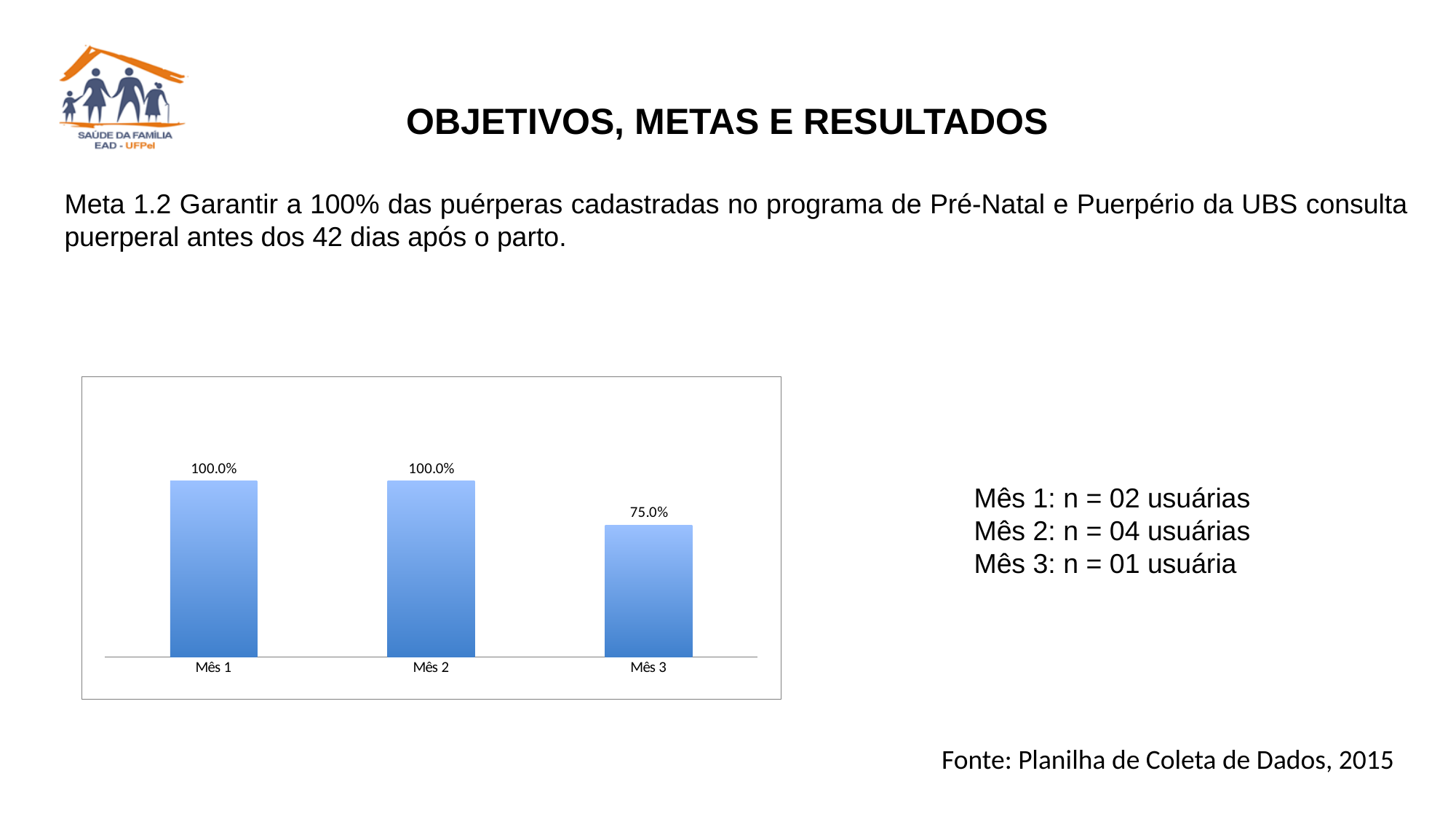
What is the difference between the values for Mês 1 and Mês 3? 25.0% How many categories are shown on the x axis of the chart? 3 Do the values rise or fall from Mês 2 to Mês 3? Fall Are the values for Mês 1 and Mês 2 equal? Yes According to the text beside the chart, how many users (usuárias) does Mês 2 correspond to? 04 usuárias What is the value for Mês 2? 100.0% What is the value for Mês 3? 75.0% What is the value for Mês 1? 100.0% What colour are the bars in the chart? Blue What kind of chart is shown on the slide? Bar chart Which category has the lowest value? Mês 3 Which is larger, the value for Mês 2 or the value for Mês 3? Mês 2